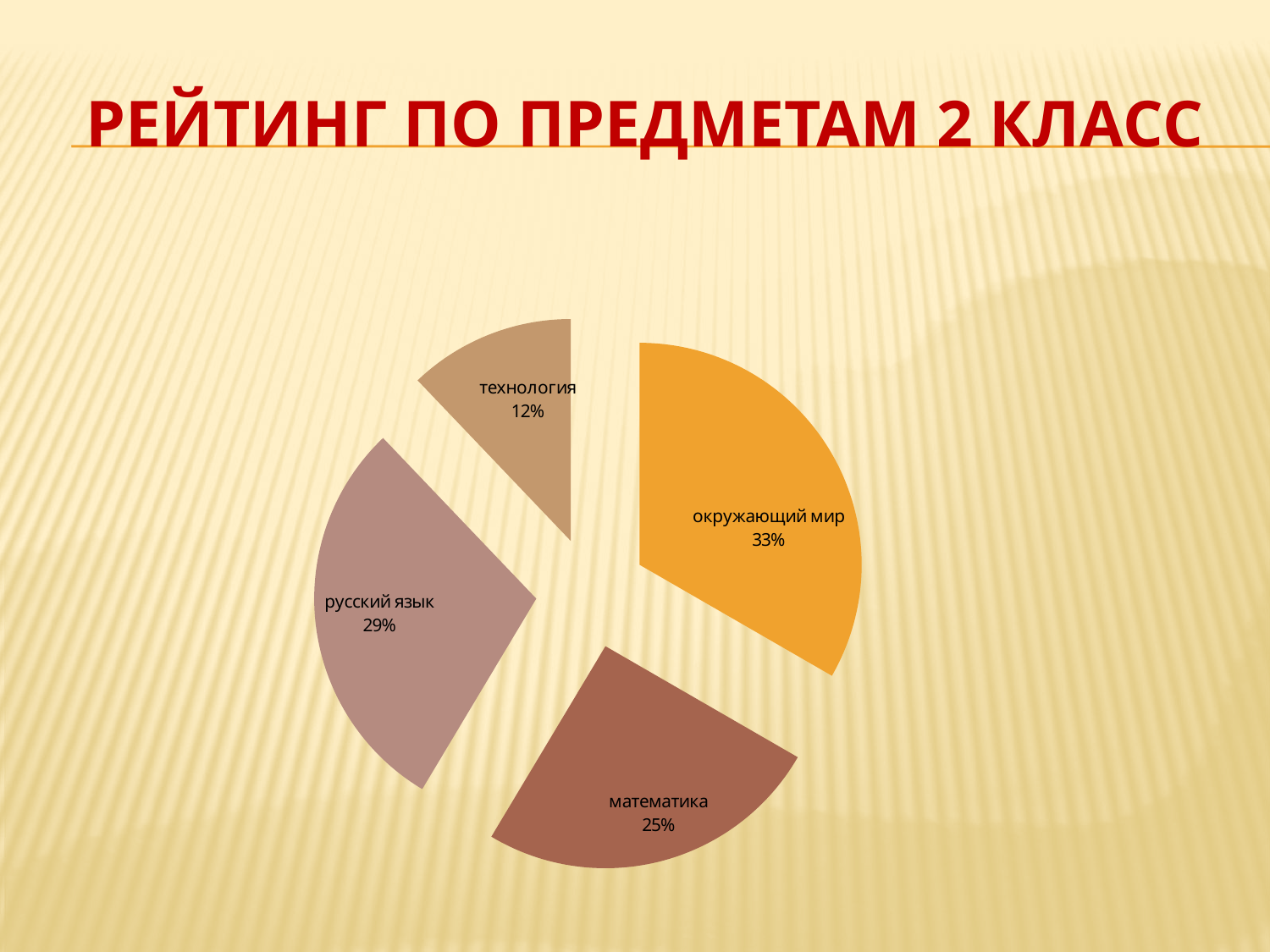
Which subject has the smallest slice of the pie? технология What is the title of the slide containing the chart? РЕЙТИНГ ПО ПРЕДМЕТАМ 2 КЛАСС What share of the pie does технология have? 12% What is the difference in percentage points between окружающий мир and технология? 21 Which subject has the largest slice of the pie? окружающий мир What is the difference in percentage points between русский язык and математика? 4 What kind of chart is shown on the slide? pie chart What share of the pie does математика have? 25% How many slices does the pie chart have? 4 Which is larger, the slice for математика or the slice for русский язык? русский язык What share of the pie does русский язык have? 29%